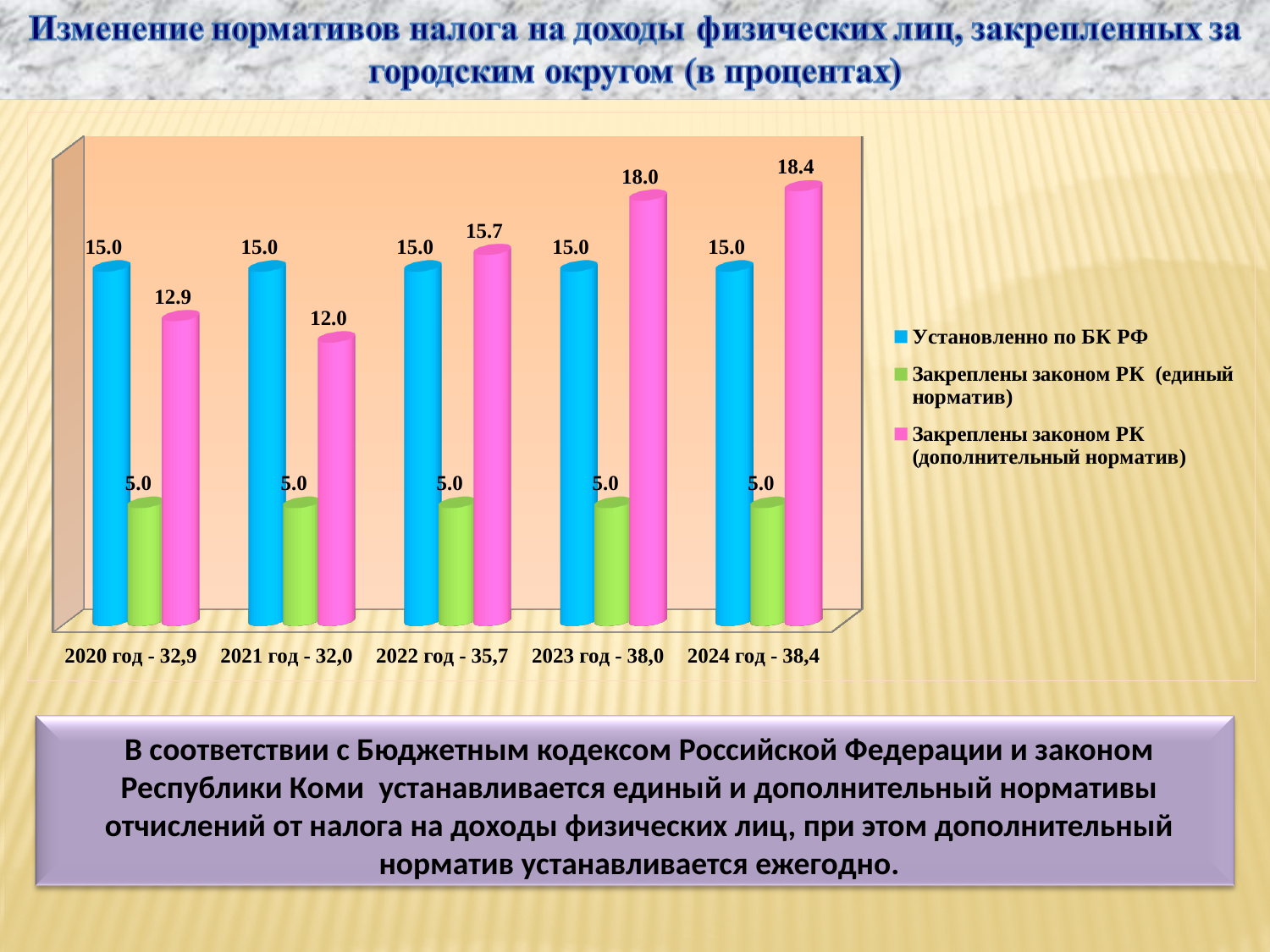
How many series does the legend list? 3 What is the value of the 'Закреплены законом РК (дополнительный норматив)' series for 2020? 12.9 Does the 'Закреплены законом РК (дополнительный норматив)' series rise or fall from 2021 to 2024? Rise In which year is the 'Закреплены законом РК (дополнительный норматив)' value the highest? 2024 What colour are the bars for the 'Закреплены законом РК (единый норматив)' series? Green Which is larger in 2022: the 'Установленно по БК РФ' value or the 'Закреплены законом РК (дополнительный норматив)' value? Закреплены законом РК (дополнительный норматив) How many year categories are shown on the x axis? 5 What kind of chart is shown on the slide? Bar chart What is the difference between the 'Закреплены законом РК (дополнительный норматив)' values for 2023 and 2021? 6.0 In which year is the 'Закреплены законом РК (дополнительный норматив)' value the lowest? 2021 What is the value of the 'Закреплены законом РК (дополнительный норматив)' series for 2024? 18.4 What is the value of the 'Установленно по БК РФ' series for 2022? 15.0